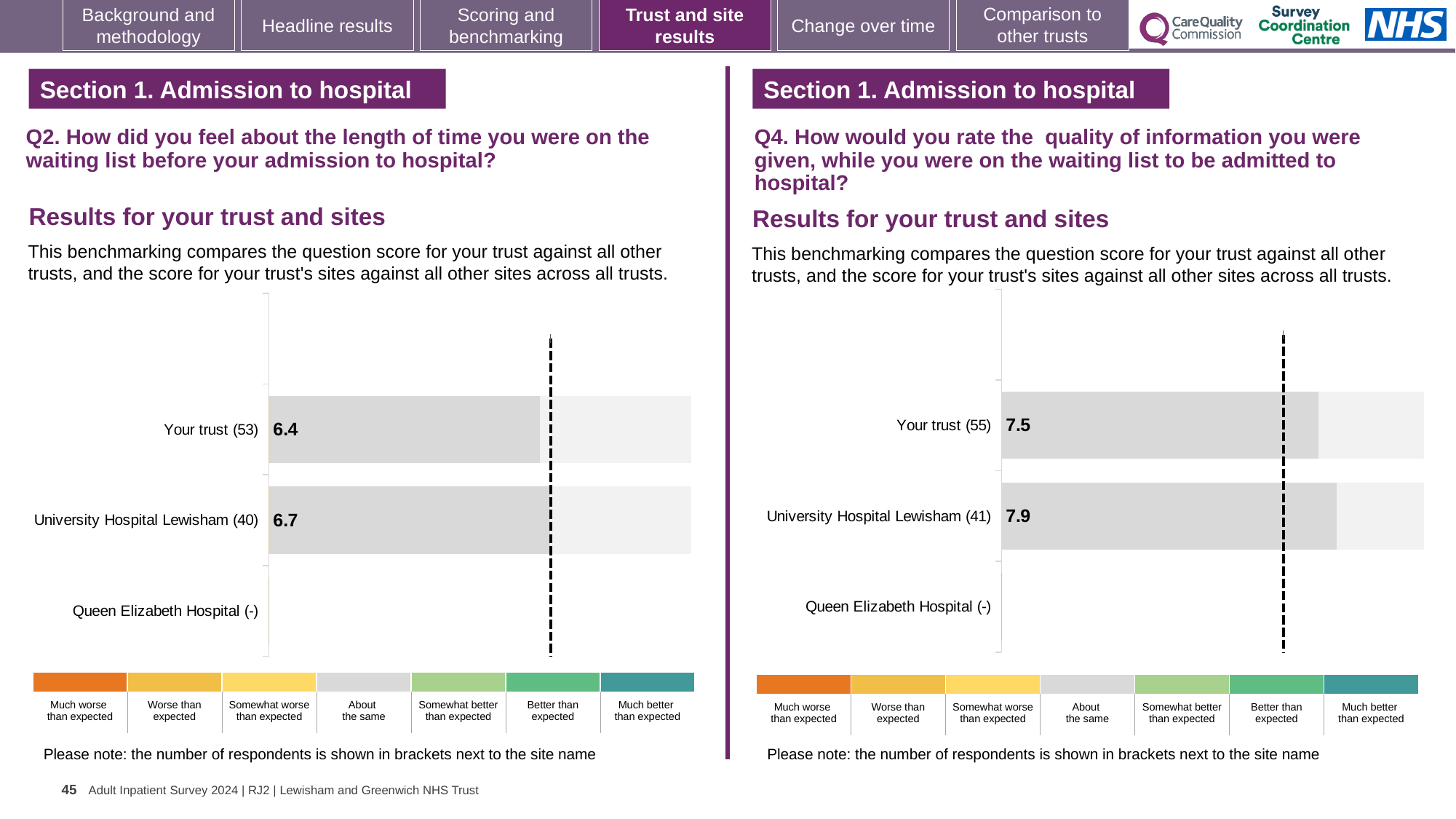
What kind of chart is the Q4 chart on the right? Bar chart How many categories are listed on the y axis of the Q2 chart on the left? 3 In the Q2 chart on the left, how many respondents are shown in brackets for Your trust? 53 In the Q4 chart on the right, how many respondents are shown in brackets for University Hospital Lewisham? 41 In the Q4 chart on the right, which site or trust has the highest score? University Hospital Lewisham In the Q2 chart on the left, what is the score for University Hospital Lewisham? 6.7 In the Q4 chart on the right, what is the difference between the University Hospital Lewisham score and the Your trust score? 0.4 In the Q4 chart on the right, what is the score for Your trust? 7.5 In the Q2 chart on the left, which is higher: the score for Your trust or for University Hospital Lewisham? University Hospital Lewisham In the Q2 chart on the left, what is the difference between the University Hospital Lewisham score and the Your trust score? 0.3 In the Q4 chart on the right, what is the score for University Hospital Lewisham? 7.9 In the Q2 chart on the left, what is the score for Your trust? 6.4